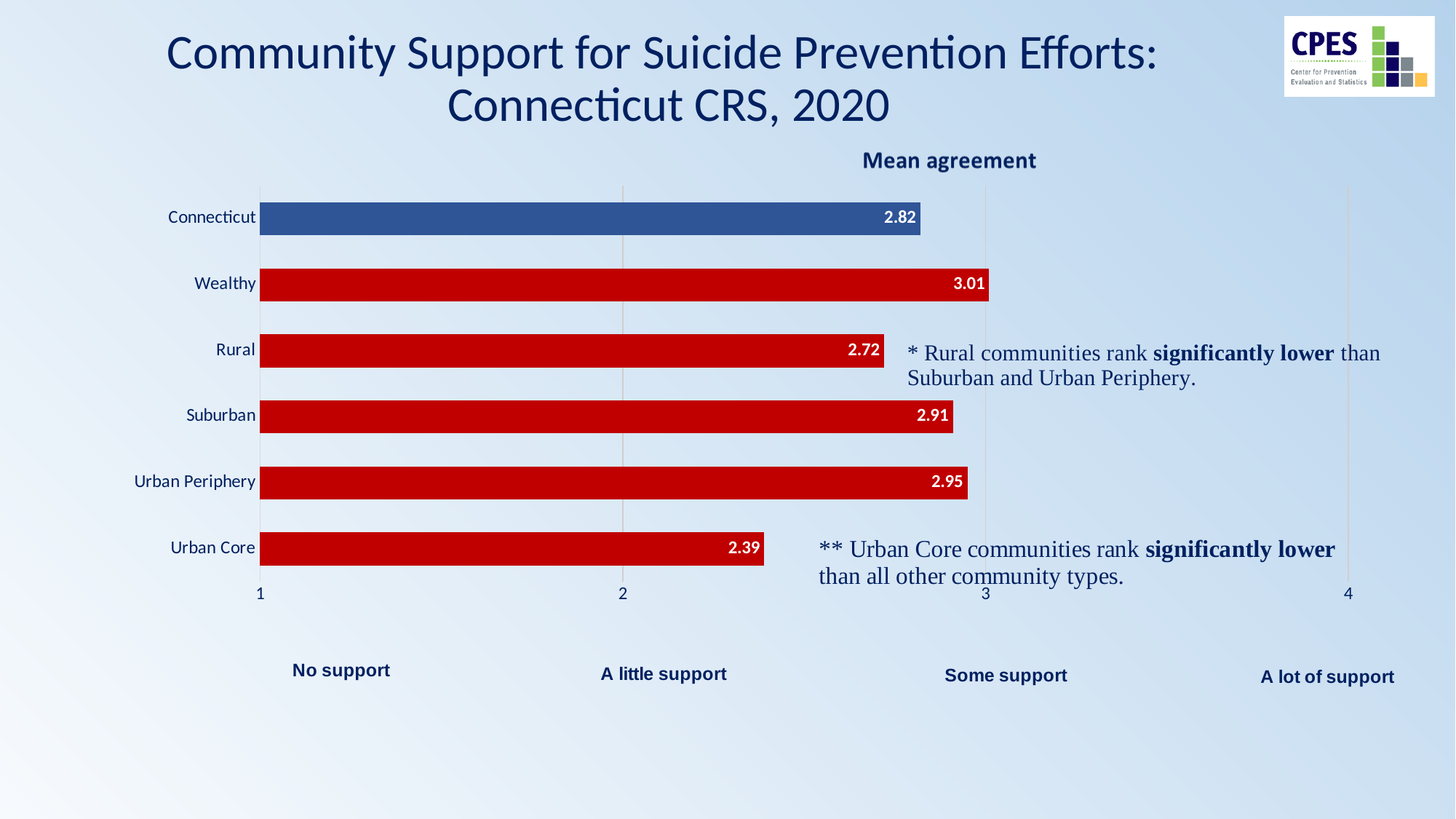
What is the mean agreement value for Wealthy communities? 3.01 Which category has the highest mean agreement? Wealthy What is the difference between the mean agreement for Urban Periphery and Suburban? 0.04 Which category has the lowest mean agreement? Urban Core Which has a higher mean agreement, Suburban or Rural? Suburban What is the mean agreement value for Rural communities? 2.72 What is the mean agreement value for Urban Core communities? 2.39 What is the mean agreement value for Connecticut? 2.82 What is the difference between the mean agreement for Wealthy and Urban Core? 0.62 How many categories are shown in the chart? 6 What kind of chart is shown on the slide? Bar chart Is the value for Wealthy greater or less than 3? greater